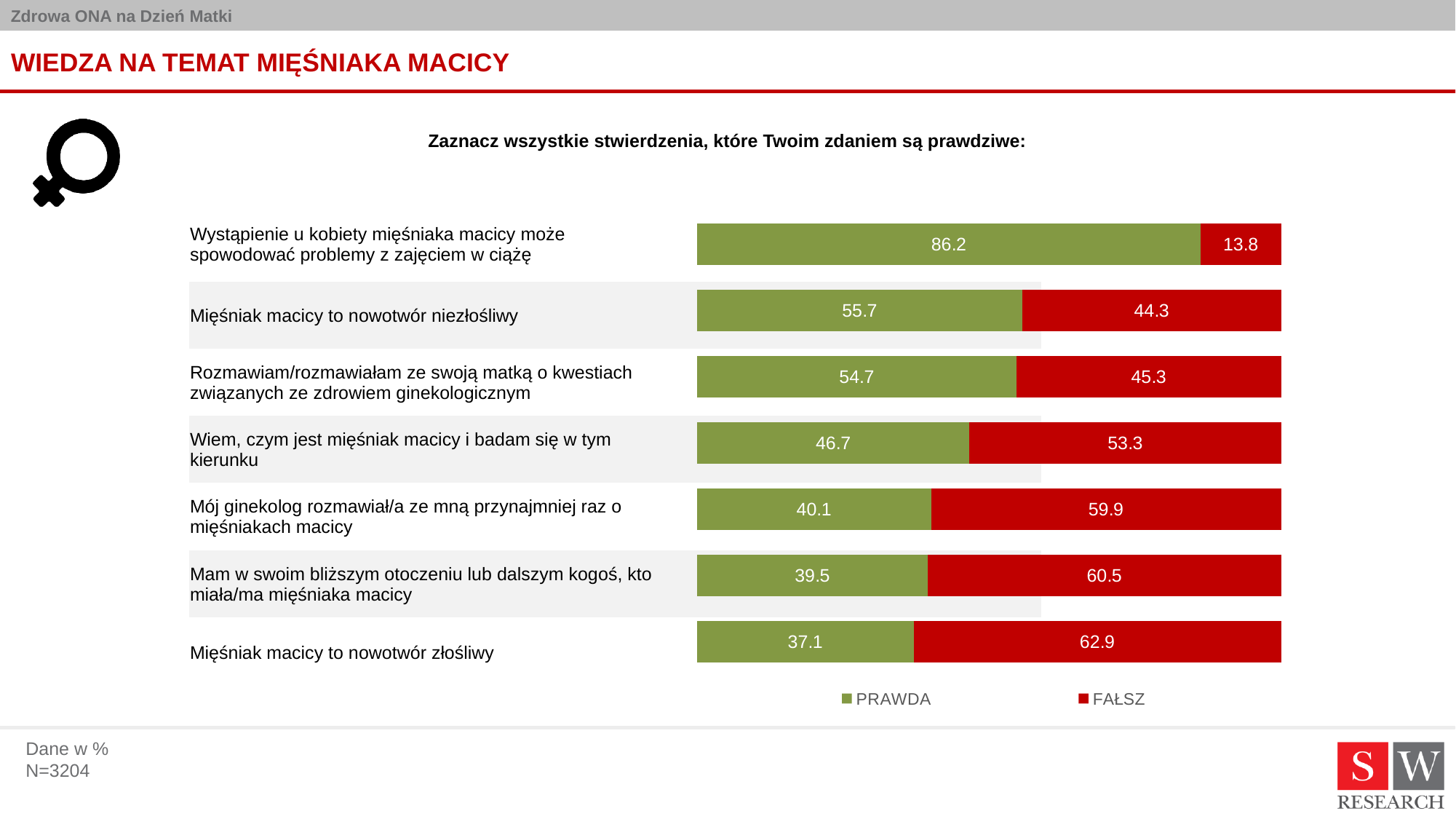
How many series does the legend list? 2 What is the FAŁSZ value for "Wystąpienie u kobiety mięśniaka macicy może spowodować problemy z zajęciem w ciążę"? 13.8 How many statements are shown in the chart? 7 Which colour represents FAŁSZ in the chart? Red Which statement has the highest PRAWDA value? Wystąpienie u kobiety mięśniaka macicy może spowodować problemy z zajęciem w ciążę What kind of chart is shown on the slide? Stacked bar chart What is the total of the stacked bar for "Rozmawiam/rozmawiałam ze swoją matką o kwestiach związanych ze zdrowiem ginekologicznym"? 100 What is the FAŁSZ value for "Mięśniak macicy to nowotwór złośliwy"? 62.9 What is the PRAWDA value for "Mięśniak macicy to nowotwór niezłośliwy"? 55.7 Which is larger: the PRAWDA value for "Wiem, czym jest mięśniak macicy i badam się w tym kierunku" or the PRAWDA value for "Mam w swoim bliższym otoczeniu lub dalszym kogoś, kto miała/ma mięśniaka macicy"? Wiem, czym jest mięśniak macicy i badam się w tym kierunku Which statement has the lowest PRAWDA value? Mięśniak macicy to nowotwór złośliwy What is the difference between the PRAWDA and FAŁSZ values for "Mój ginekolog rozmawiał/a ze mną przynajmniej raz o mięśniakach macicy"? 19.8